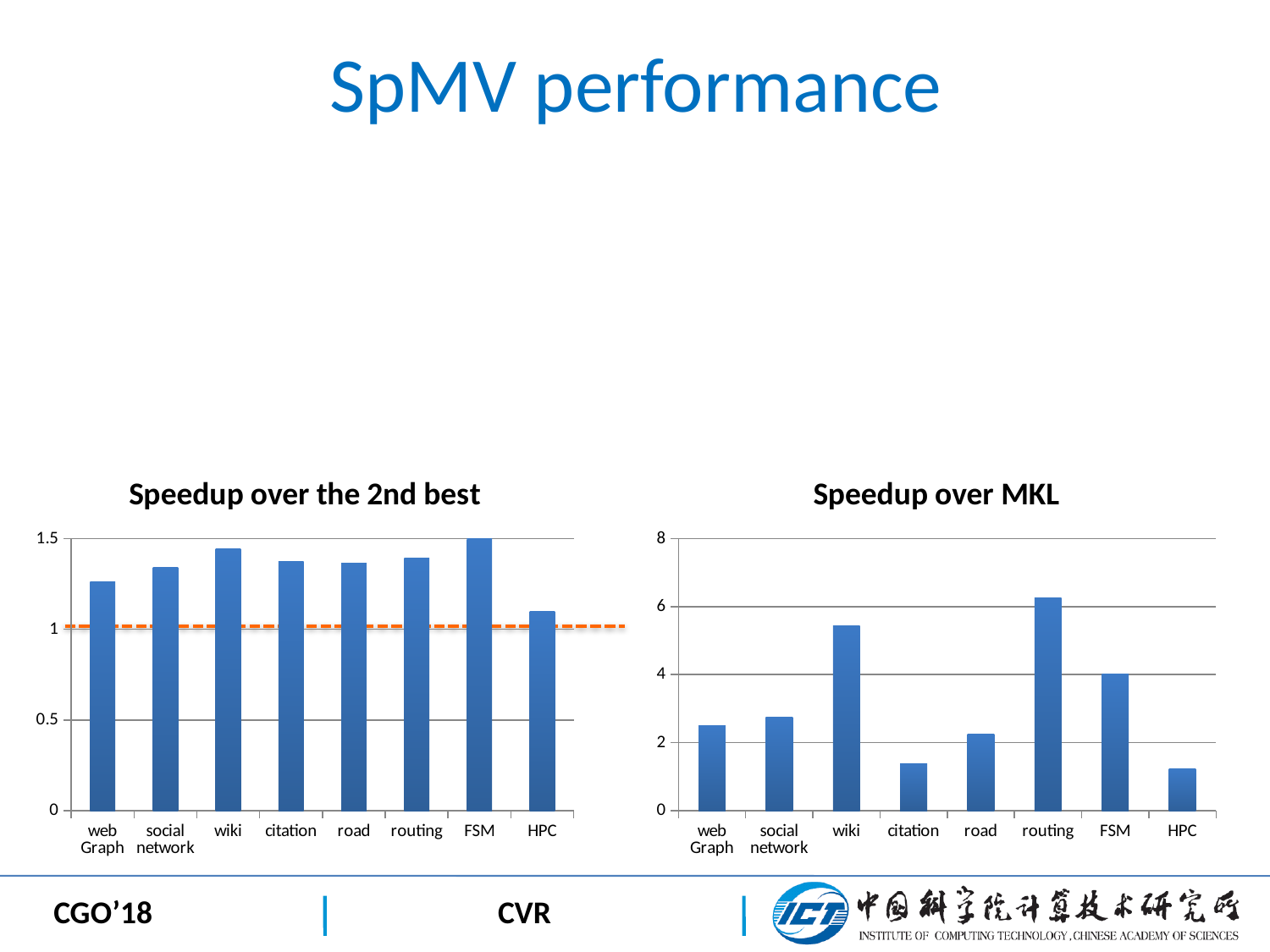
In the 'Speedup over MKL' chart, is the value for wiki greater or less than 4? greater What kind of chart is the 'Speedup over the 2nd best' chart? bar chart In the 'Speedup over MKL' chart, is the value for routing greater or less than 6? greater In the 'Speedup over the 2nd best' chart, which is larger, the value for web Graph or the value for social network? social network In the 'Speedup over MKL' chart, which category has the highest bar? routing In the 'Speedup over MKL' chart, is the value for citation greater or less than 2? less In the 'Speedup over the 2nd best' chart, which category has the lowest bar? HPC In the 'Speedup over the 2nd best' chart, at what y-axis value is the orange dashed horizontal line drawn? 1 How many categories are shown on the x axis of the 'Speedup over MKL' chart? 8 In the 'Speedup over the 2nd best' chart, which category has the highest bar? FSM In the 'Speedup over MKL' chart, which is larger, the value for wiki or the value for FSM? wiki